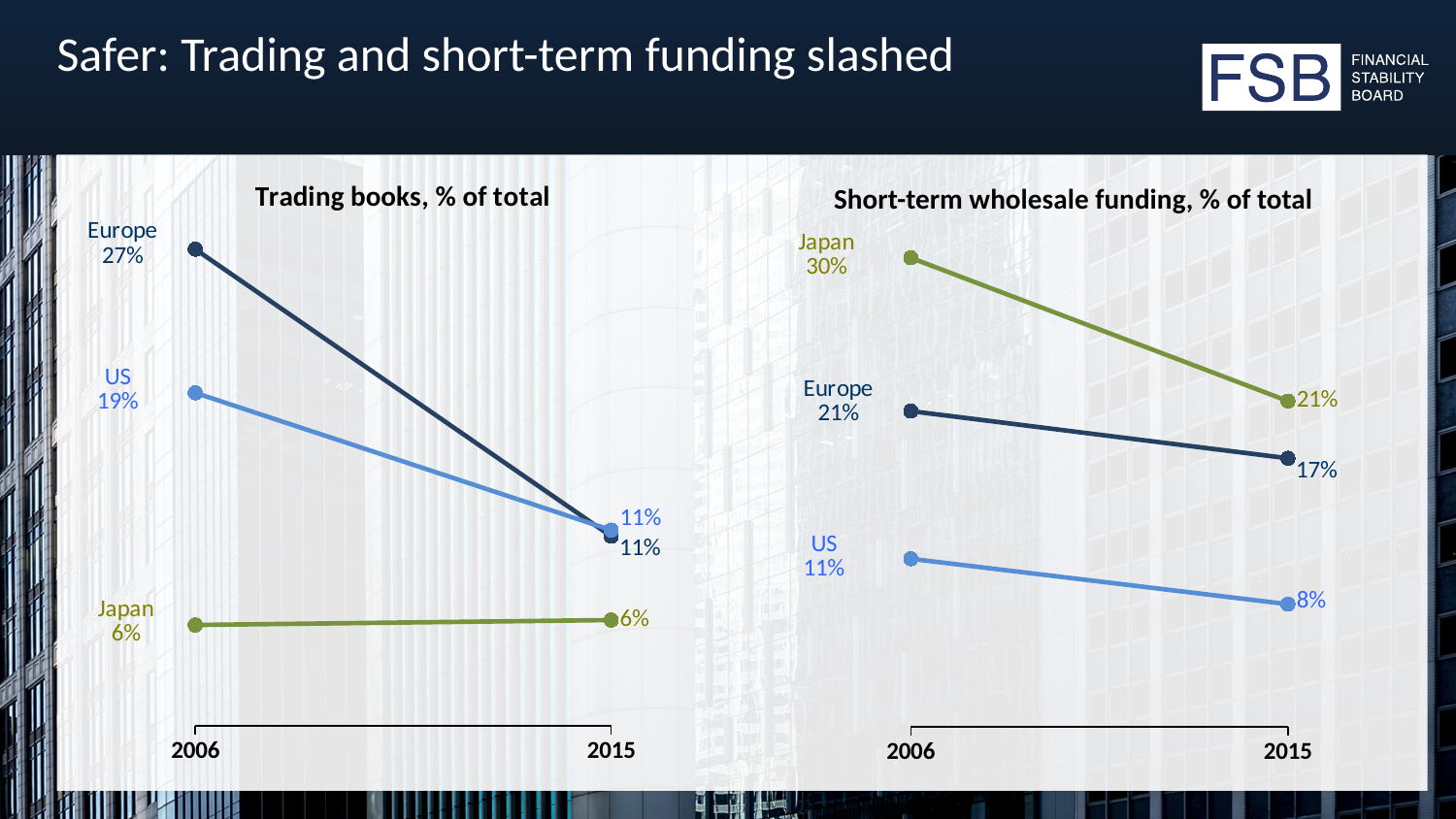
In the 'Trading books, % of total' chart, what was Europe's value in 2006? 27% In the 'Short-term wholesale funding, % of total' chart, what was the US value in 2006? 11% In the 'Short-term wholesale funding, % of total' chart, is Europe's 2015 value larger or smaller than Japan's 2015 value? Smaller In the 'Short-term wholesale funding, % of total' chart, what is the difference between Japan's and Europe's values in 2015? 4 percentage points How many regions are plotted in the 'Short-term wholesale funding, % of total' chart? 3 What type of chart is the 'Trading books, % of total' chart? Line chart In the 'Short-term wholesale funding, % of total' chart, what was Japan's value in 2015? 21% In the 'Trading books, % of total' chart, by how many percentage points did Europe's value fall from 2006 to 2015? 16 percentage points In the 'Trading books, % of total' chart, which region had the highest value in 2006? Europe In the 'Short-term wholesale funding, % of total' chart, which region had the lowest value in 2015? US In the 'Trading books, % of total' chart, what was the US value in 2015? 11%